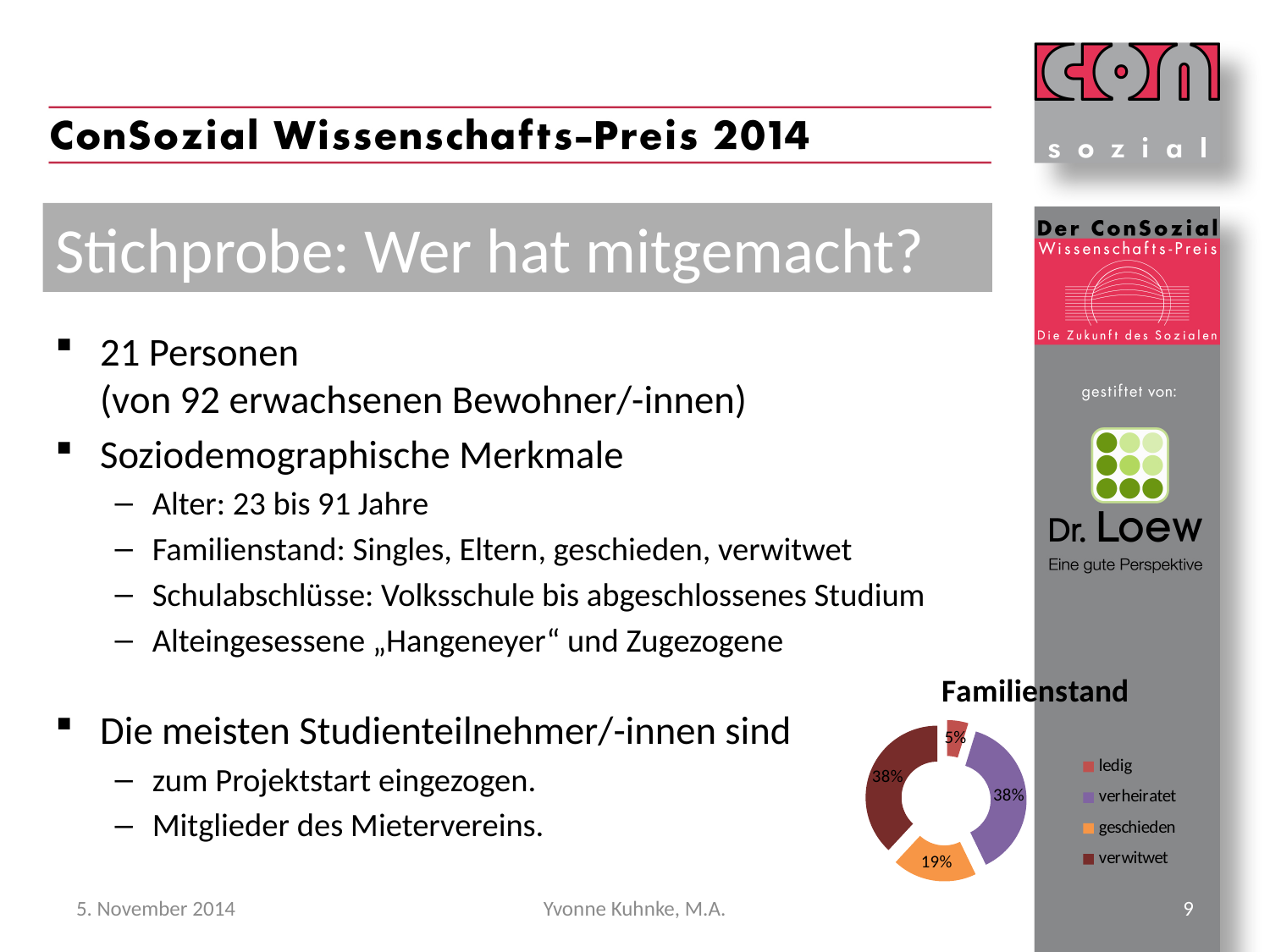
What is the title of the chart on the slide? Familienstand Which category has the smallest share in the Familienstand chart? ledig What share of the Familienstand chart is labelled "geschieden"? 19% In the Familienstand chart, which is larger: geschieden or ledig? geschieden What kind of chart is the Familienstand chart? doughnut chart What is the difference in percentage points between geschieden and ledig in the Familienstand chart? 14 In the Familienstand chart, which is larger: verheiratet or geschieden? verheiratet What share of the Familienstand chart is labelled "verheiratet"? 38% What share of the Familienstand chart is labelled "ledig"? 5% How many categories does the legend of the Familienstand chart list? 4 What share of the Familienstand chart is labelled "verwitwet"? 38% What is the difference in percentage points between verheiratet and geschieden in the Familienstand chart? 19